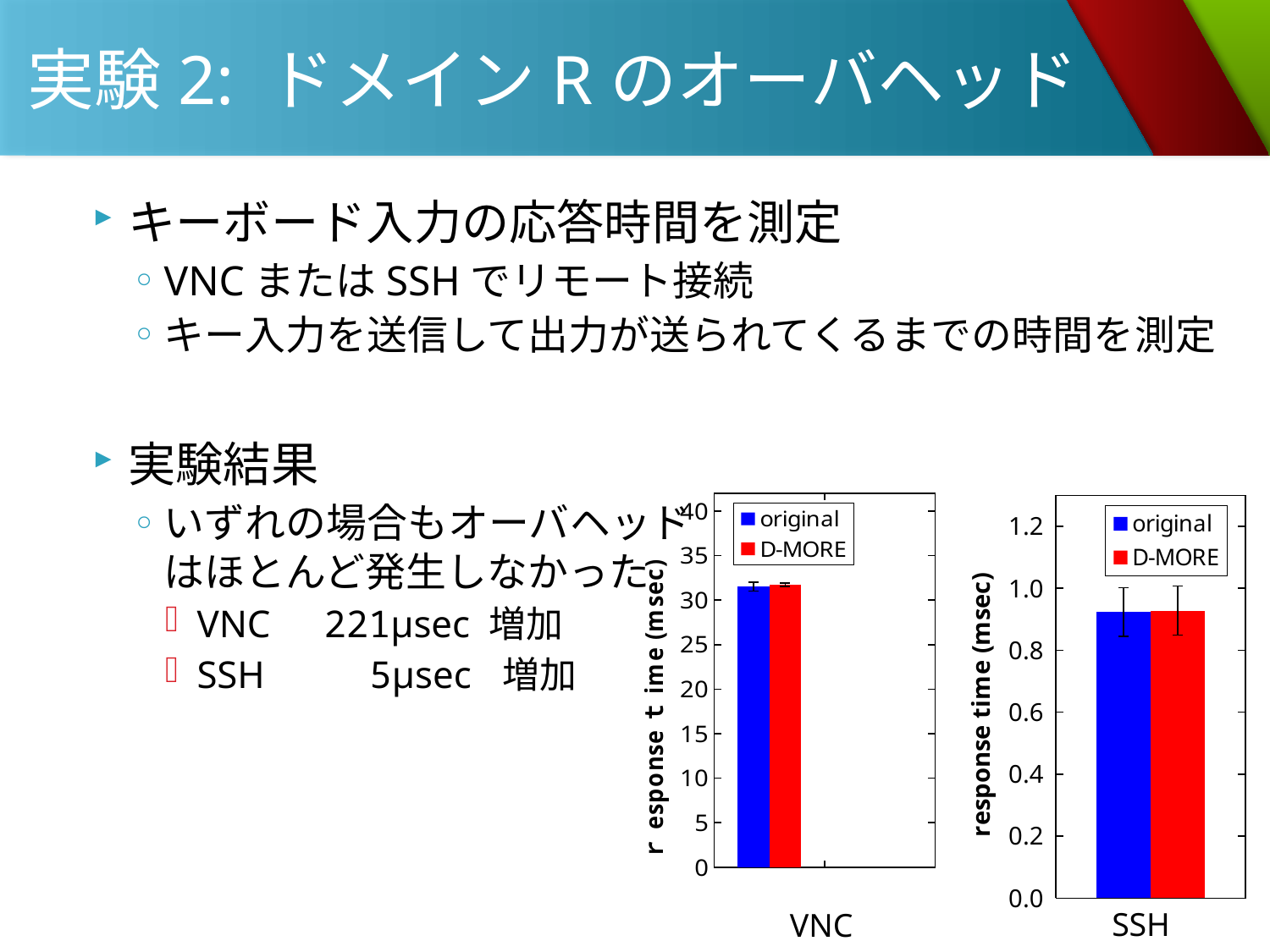
What kind of chart is the VNC chart on the left? bar chart In the VNC chart, which series is drawn in red? D-MORE What is the y-axis label of the SSH chart? response time (msec) In the VNC chart, is the value for original greater or less than 30? greater In the SSH chart, is the value for original greater or less than 0.8? greater How many series does the legend of the VNC chart list? 2 What kind of chart is the SSH chart on the right? bar chart How many series does the legend of the SSH chart list? 2 In the SSH chart, is the value for D-MORE greater or less than 1.0? less How many bars are plotted in the SSH chart? 2